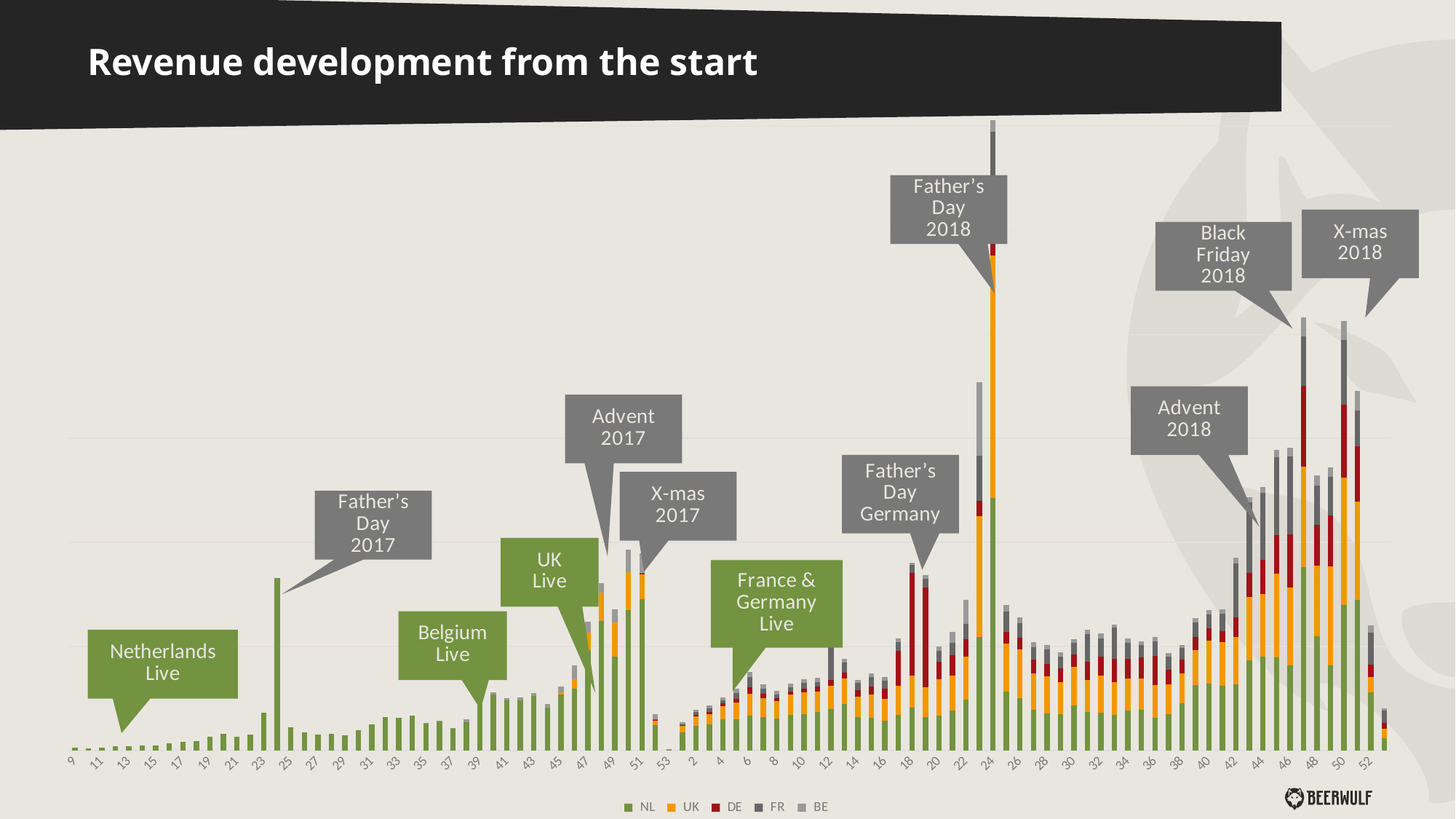
What is the title of the chart? Revenue development from the start Which bar is taller: the one annotated Black Friday 2018 or the one annotated X-mas 2017? Black Friday 2018 Which bar is taller: the one annotated Father's Day 2018 or the one annotated Father's Day 2017? Father's Day 2018 Overall, do the bar heights rise or fall from left to right along the x axis? Rise What kind of chart is shown on the slide? Stacked bar chart Which annotated event marks the tallest bar in the chart? Father's Day 2018 Which series forms the bottom (green) segment of each stacked bar? NL How many series does the legend list? 5 Which series are listed in the legend? NL, UK, DE, FR, BE Which bar is taller: the one annotated Advent 2017 or the one annotated Advent 2018? Advent 2018